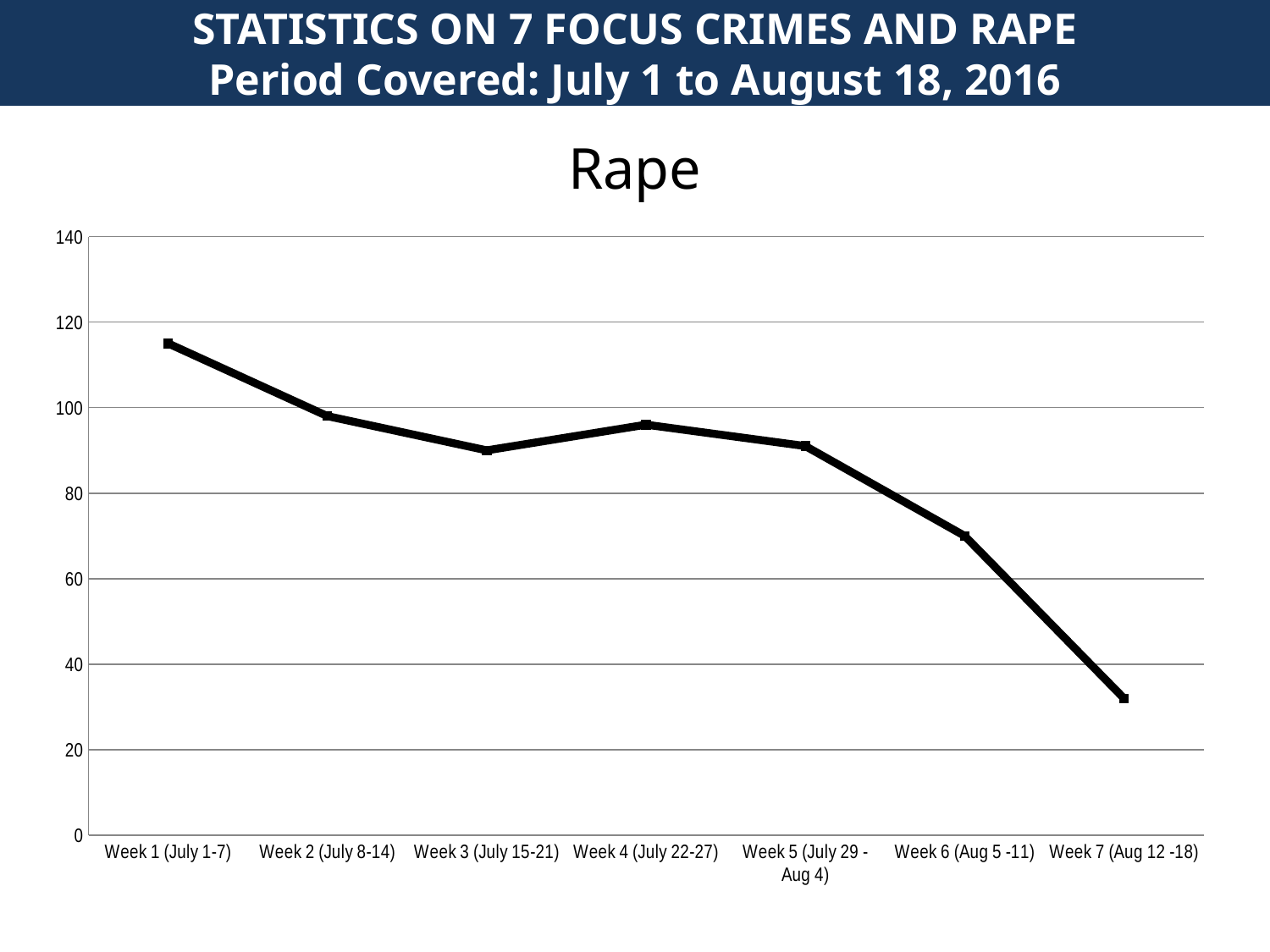
Is the value for Week 6 (Aug 5 -11) greater or less than 80? less What is the highest value shown on the y axis? 140 What is the title of the chart? Rape Which is larger, the value for Week 2 (July 8-14) or the value for Week 6 (Aug 5 -11)? Week 2 (July 8-14) How many weeks are plotted on the x axis? 7 Overall, do the values rise or fall from Week 1 to Week 7? fall Is the value for Week 1 (July 1-7) greater or less than 100? greater Which week has the lowest value? Week 7 (Aug 12 -18) Is the value for Week 7 (Aug 12 -18) greater or less than 40? less Which week has the highest value? Week 1 (July 1-7) What kind of chart is shown on the slide? line chart